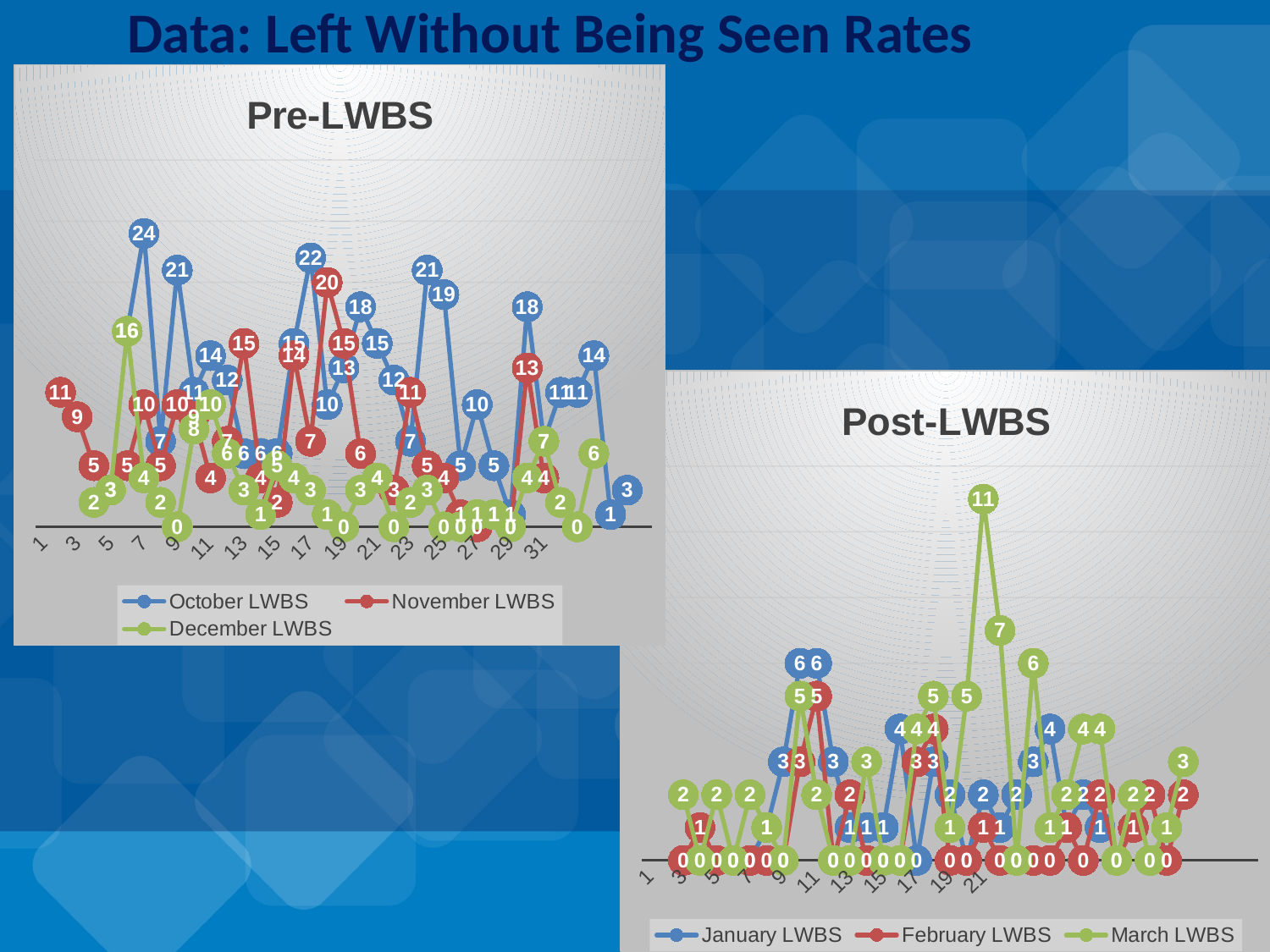
Which series are listed in the legend of the Post-LWBS chart? January LWBS, February LWBS, March LWBS In the Post-LWBS chart, what is the highest value reached by the January LWBS series? 6 In the Post-LWBS chart, which series reaches the highest peak value? March LWBS How many series does the legend of the Post-LWBS chart list? 3 In the Pre-LWBS chart, which series reaches the highest peak value? October LWBS How many series does the legend of the Pre-LWBS chart list? 3 In the Pre-LWBS chart, what is the difference between the peak value of October LWBS and the peak value of November LWBS? 4 What kind of chart is the Pre-LWBS chart? line chart